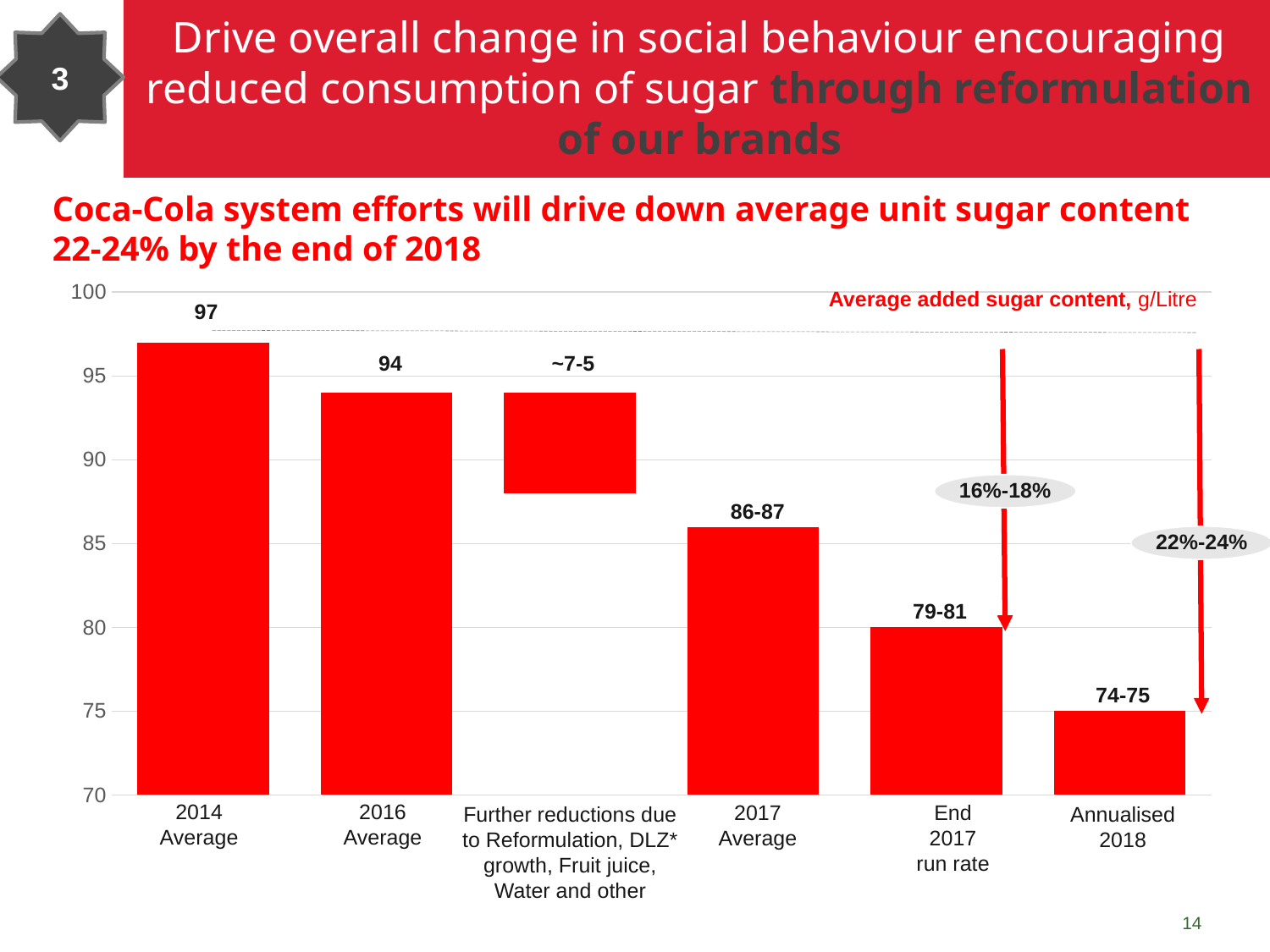
What is the average added sugar content for the 2014 Average? 97 What value is shown for the 2016 Average bar? 94 What value is labelled on the End 2017 run rate bar? 79-81 What kind of chart is shown on the slide? Bar chart What value is labelled on the Annualised 2018 bar? 74-75 What value is labelled on the 2017 Average bar? 86-87 Which category has the highest average added sugar content? 2014 Average In what unit is the average added sugar content measured on the chart? g/Litre By how much did the average added sugar content fall from the 2014 Average to the 2016 Average? 3 Which category has the lowest average added sugar content? Annualised 2018 Is the value for the 2017 Average greater or less than 85? greater Which is larger, the 2014 Average or the 2016 Average? 2014 Average